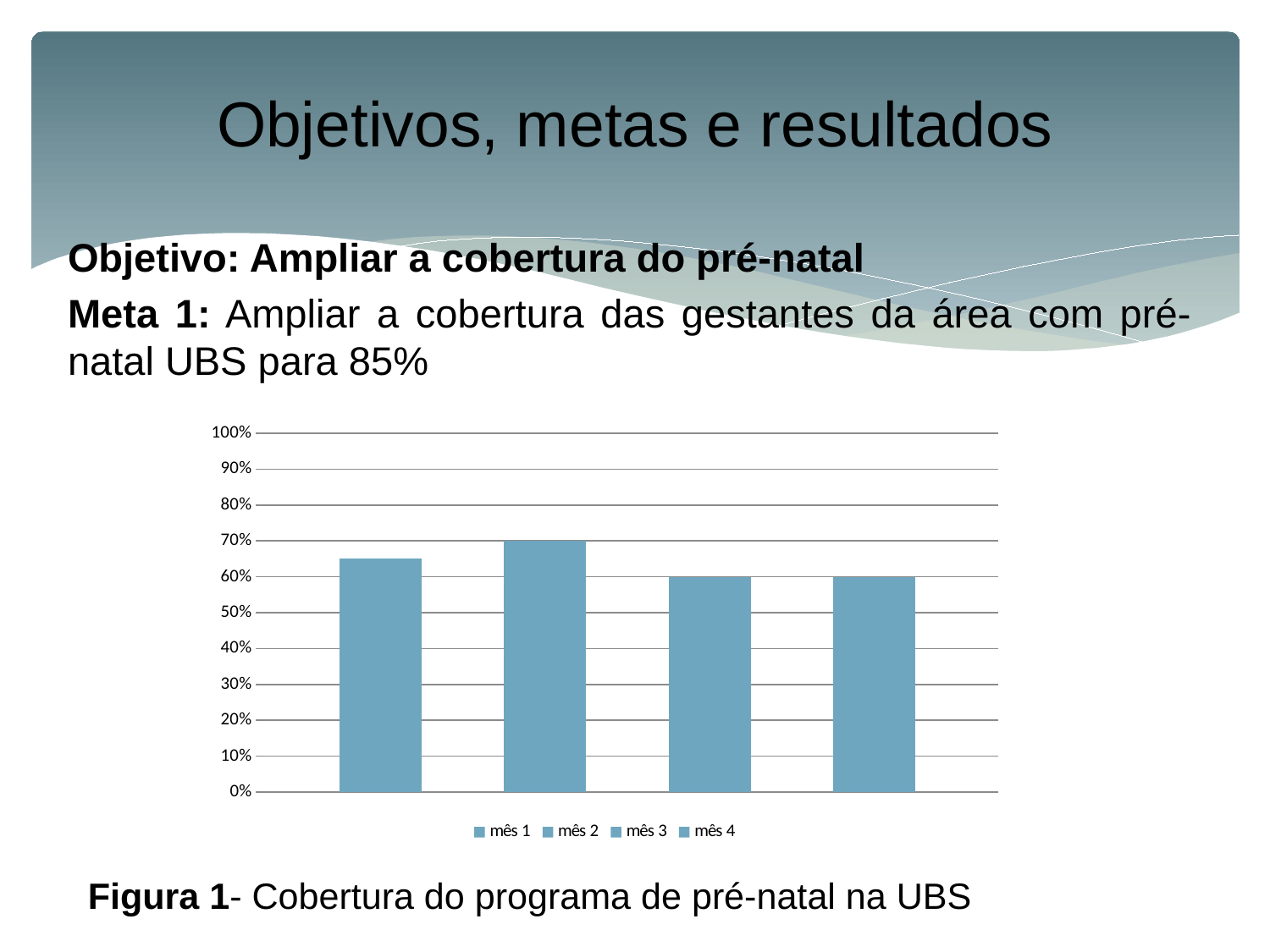
What kind of chart is shown on the slide? bar chart What is the value for mês 3? 60% Which is larger, the value for mês 1 or the value for mês 2? mês 2 How many bars are plotted in the chart? 4 How many entries does the chart legend list? 4 Is the value for mês 1 greater or less than 70%? less Is the value for mês 1 greater or less than 60%? greater Which month has the highest value in the chart? mês 2 What is the value for mês 2? 70% What is the value for mês 4? 60% What is the difference between the values for mês 2 and mês 3? 10% What is the caption given for the figure below the chart? Figura 1- Cobertura do programa de pré-natal na UBS